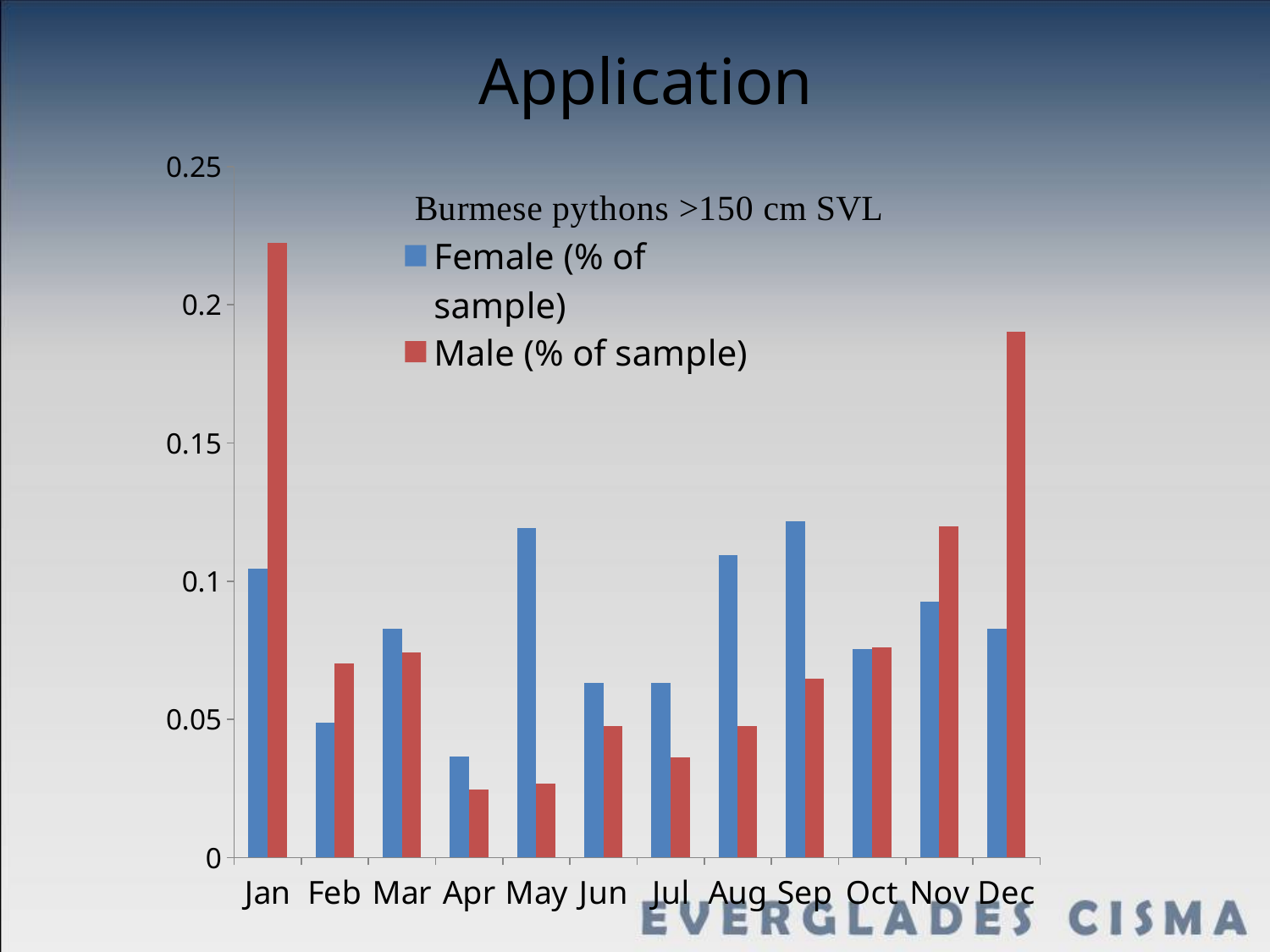
What kind of chart is shown on the slide? bar chart In Jan, which is larger: the Female (% of sample) value or the Male (% of sample) value? Male (% of sample) How many series does the chart's legend list? 2 In May, which is larger: the Female (% of sample) value or the Male (% of sample) value? Female (% of sample) Is the Male (% of sample) value for Dec greater or less than 0.15? greater In which month is the Female (% of sample) value lowest? Apr Is the Female (% of sample) value for May greater or less than 0.1? greater What text appears above the legend entries in the chart? Burmese pythons >150 cm SVL Is the Female (% of sample) value for Apr greater or less than 0.05? less In which month is the Male (% of sample) value highest? Jan How many months are shown on the x axis of the chart? 12